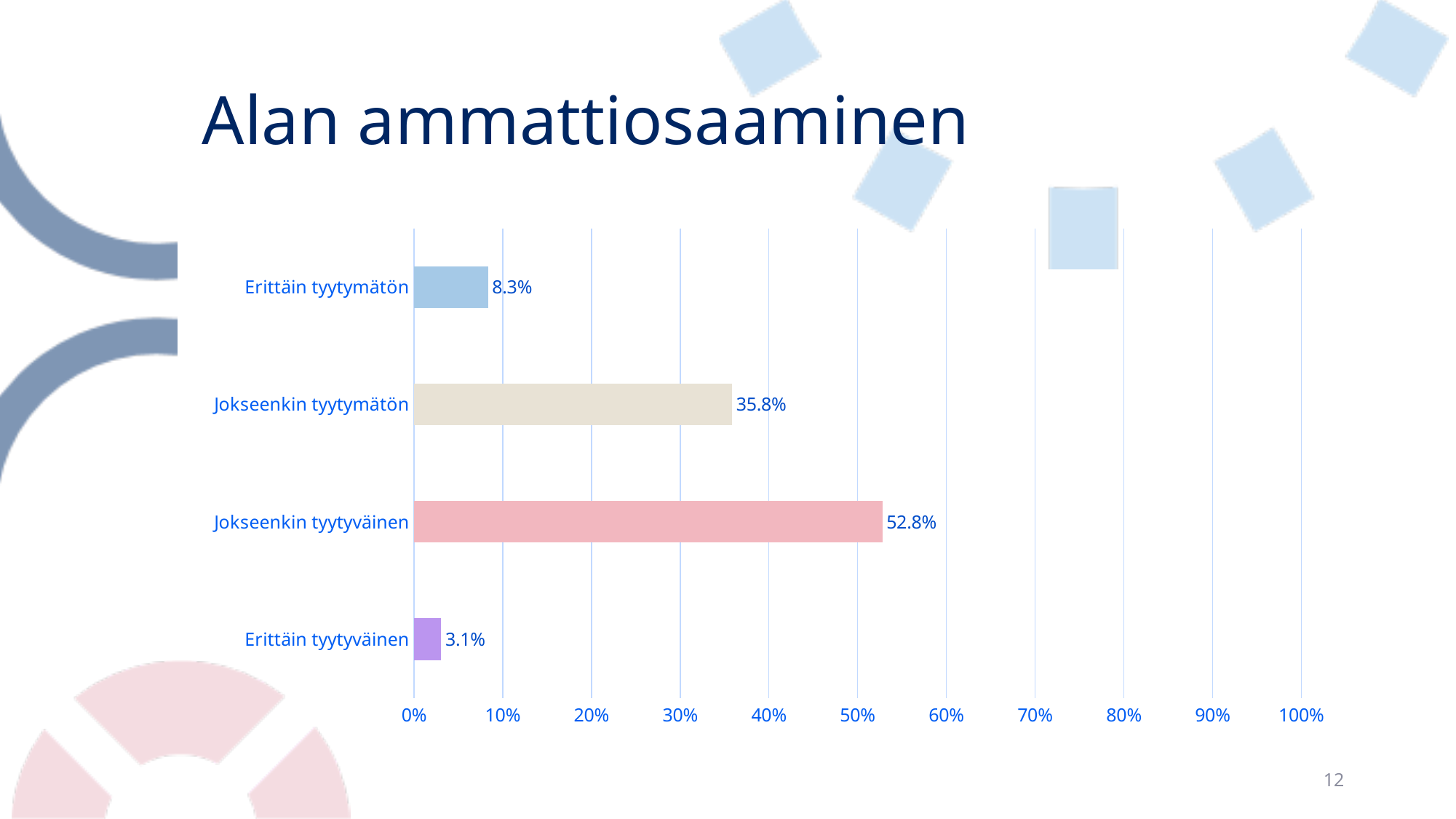
Which category has the highest value? Jokseenkin tyytyväinen Is the value for Jokseenkin tyytymätön greater or less than 40%? less What kind of chart is shown on the slide? bar chart What is the value for Jokseenkin tyytyväinen? 52.8% Which is larger, the value for Erittäin tyytymätön or the value for Erittäin tyytyväinen? Erittäin tyytymätön What is the title of the slide containing the chart? Alan ammattiosaaminen Which category has the lowest value? Erittäin tyytyväinen What is the difference between the values for Jokseenkin tyytyväinen and Jokseenkin tyytymätön? 17.0% What is the value for Jokseenkin tyytymätön? 35.8% What is the value for Erittäin tyytyväinen? 3.1% What is the value for Erittäin tyytymätön? 8.3% How many categories are shown in the chart? 4